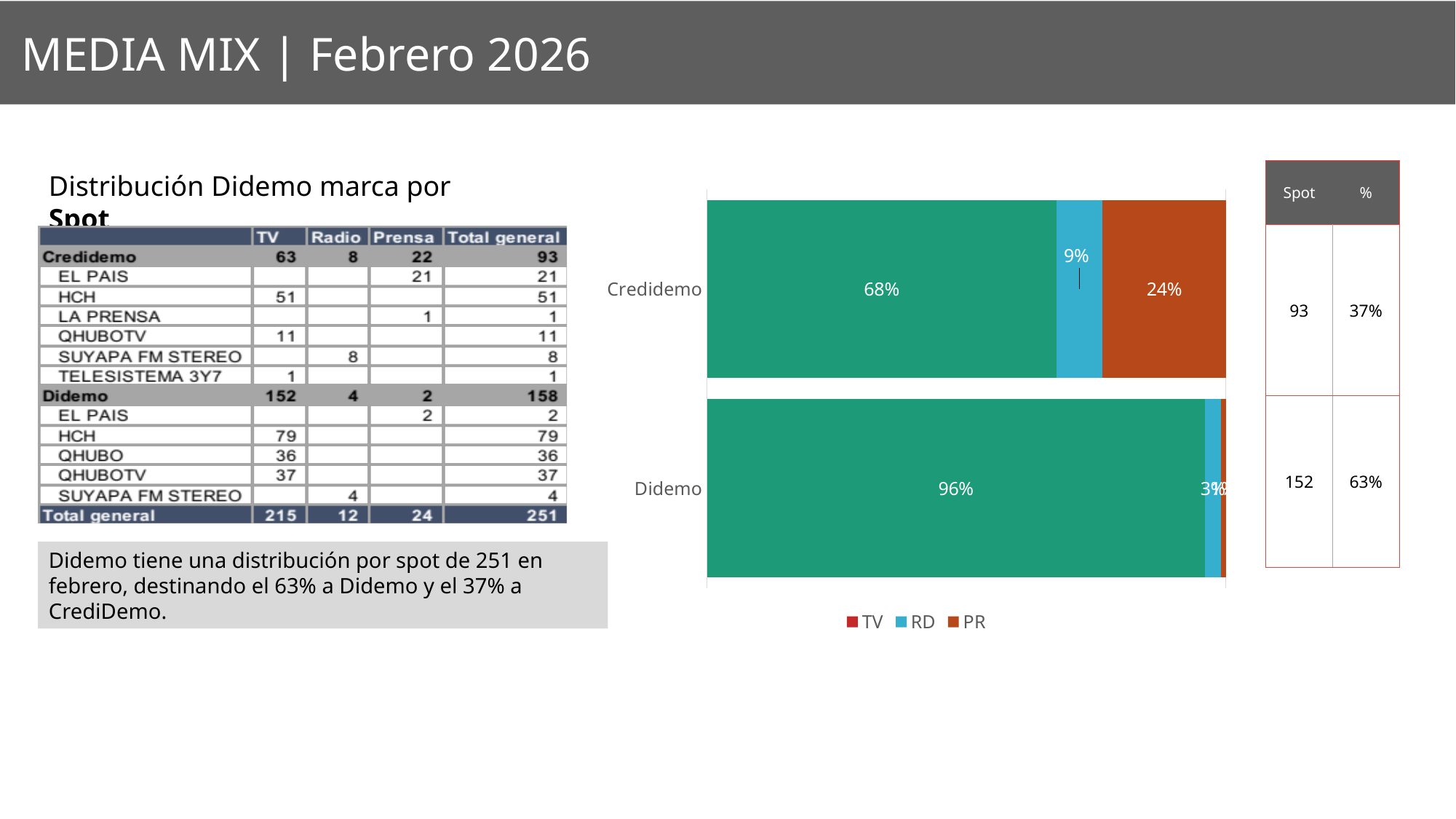
Which category has the larger TV share, Credidemo or Didemo? Didemo How many series does the chart legend list? 3 What is the TV share for Credidemo in the chart? 68% What is the TV share for Didemo in the chart? 96% Which series has the largest share in the Credidemo bar? TV Which series has the smallest share in the Credidemo bar? RD How many categories (bars) does the chart show? 2 Which series does the chart legend list? TV, RD, PR What is the PR share for Credidemo in the chart? 24% What is the RD share for Credidemo in the chart? 9% What is the difference between the TV share for Didemo and the TV share for Credidemo? 28 percentage points What kind of chart is shown on the slide? Stacked bar chart